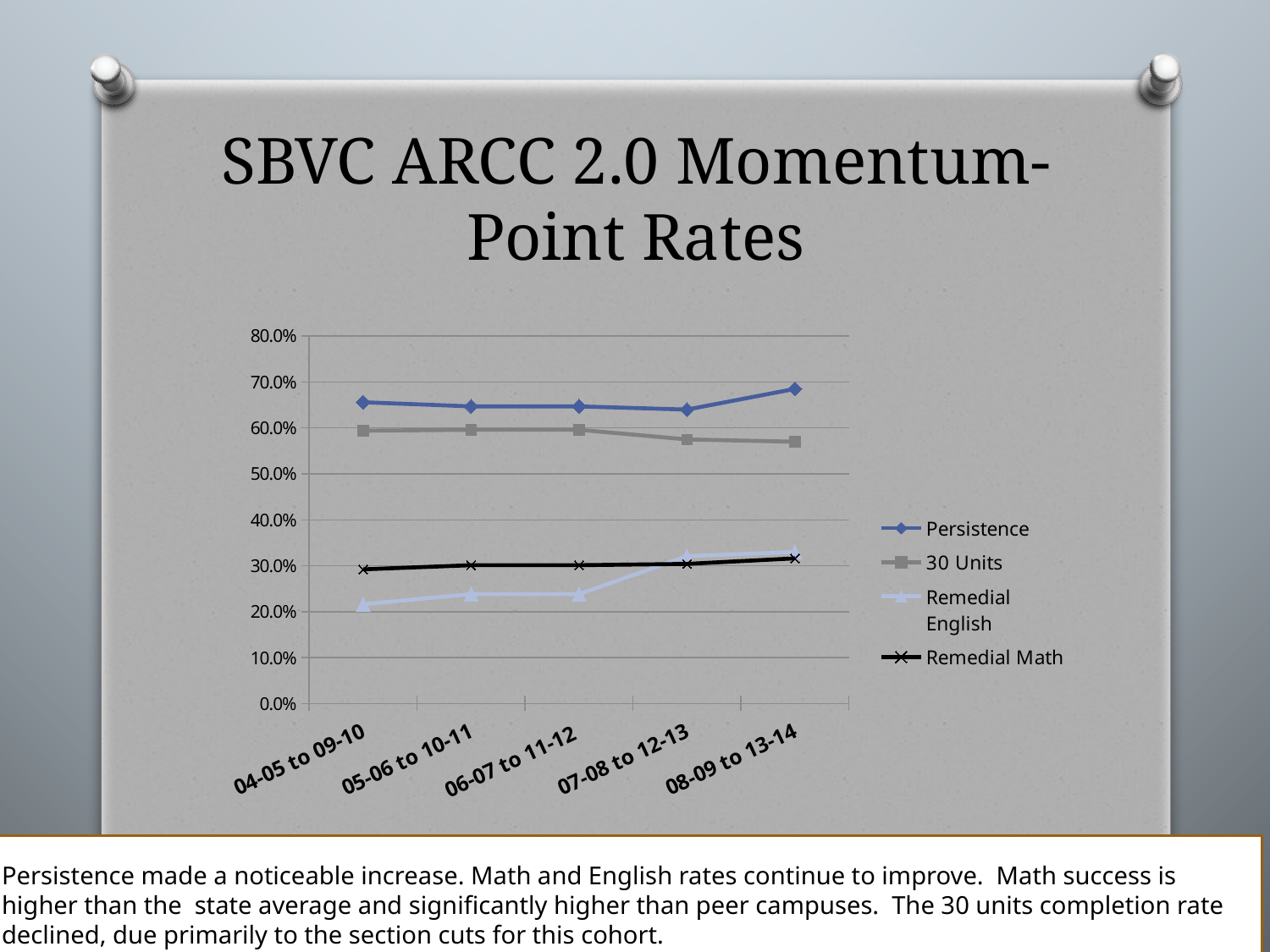
Is the Remedial English value for 04-05 to 09-10 greater or less than 30.0%? less Which series has the highest values across all cohort periods? Persistence Is the 30 Units value for 08-09 to 13-14 greater or less than 60.0%? less Does the Remedial English series rise or fall from 04-05 to 09-10 to 08-09 to 13-14? Rise Which is larger in the 04-05 to 09-10 cohort, Remedial Math or Remedial English? Remedial Math How many cohort periods are shown along the x axis? 5 What kind of chart is shown on the slide? Line chart Is the Persistence value for 08-09 to 13-14 greater or less than 60.0%? greater Does the 30 Units series rise or fall from 04-05 to 09-10 to 08-09 to 13-14? Fall Which series has the lowest value in the 04-05 to 09-10 cohort? Remedial English How many series does the legend list? 4 What is the title of the slide containing the chart? SBVC ARCC 2.0 Momentum-Point Rates